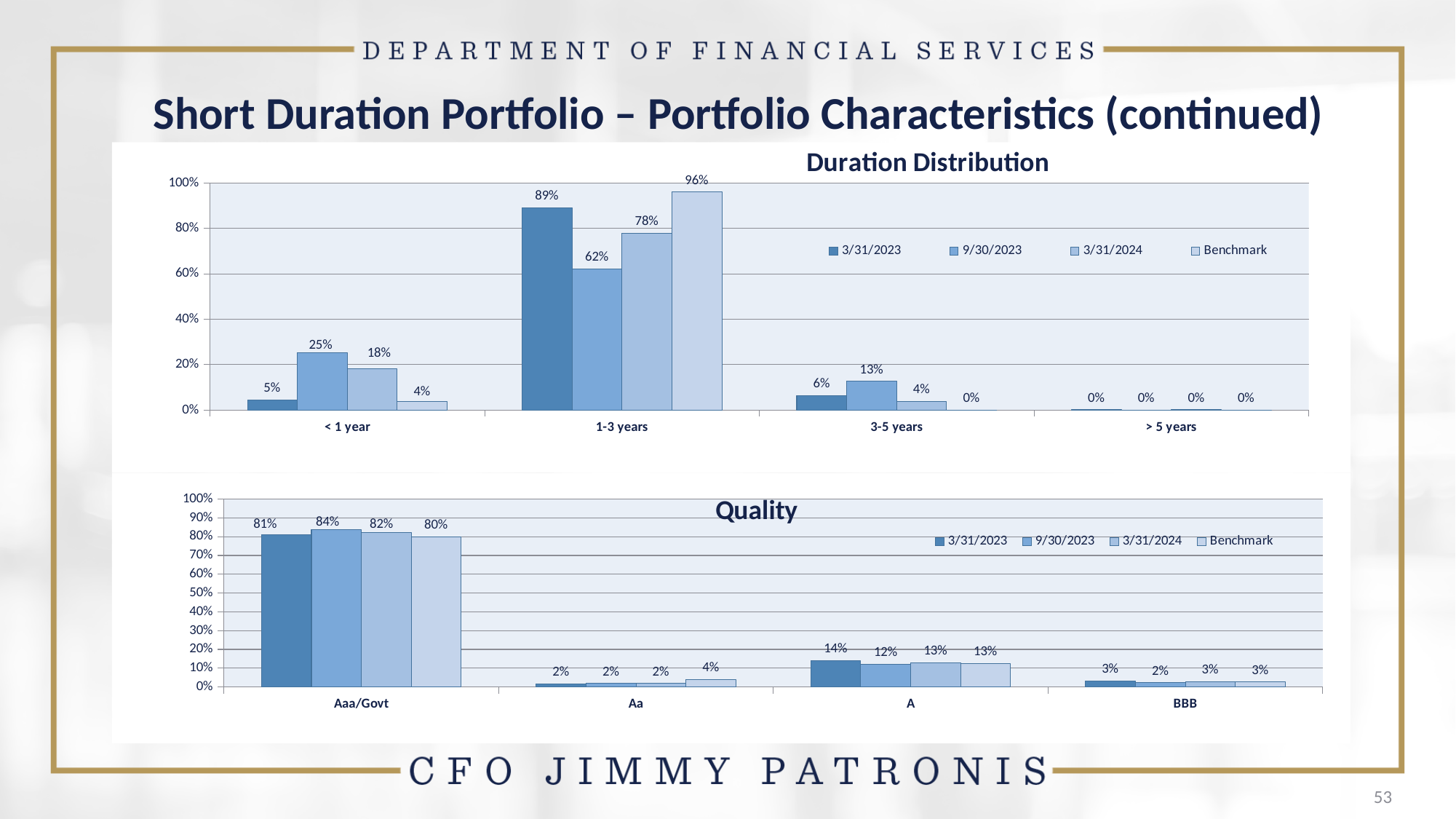
In the Duration Distribution chart, what is the difference between the Benchmark and the 3/31/2023 values for 1-3 years? 7% In the Duration Distribution chart, which is larger for 3-5 years: the 3/31/2023 value or the 9/30/2023 value? 9/30/2023 How many categories are shown on the x axis of the Quality chart? 4 What type of chart is the Quality chart? Bar chart How many series does the legend of the Duration Distribution chart list? 4 In the Duration Distribution chart, what is the value for 1-3 years for the 3/31/2024 series? 78% In the Quality chart, what is the Benchmark value for Aa? 4% In the Duration Distribution chart, which category has the highest value for the 9/30/2023 series? 1-3 years In the Duration Distribution chart, what is the Benchmark value for < 1 year? 4% In the Quality chart, what is the difference between the 9/30/2023 and Benchmark values for Aaa/Govt? 4% In the Quality chart, what is the value for A for the 3/31/2023 series? 14% In the Quality chart, which category has the lowest value for the 3/31/2024 series? Aa